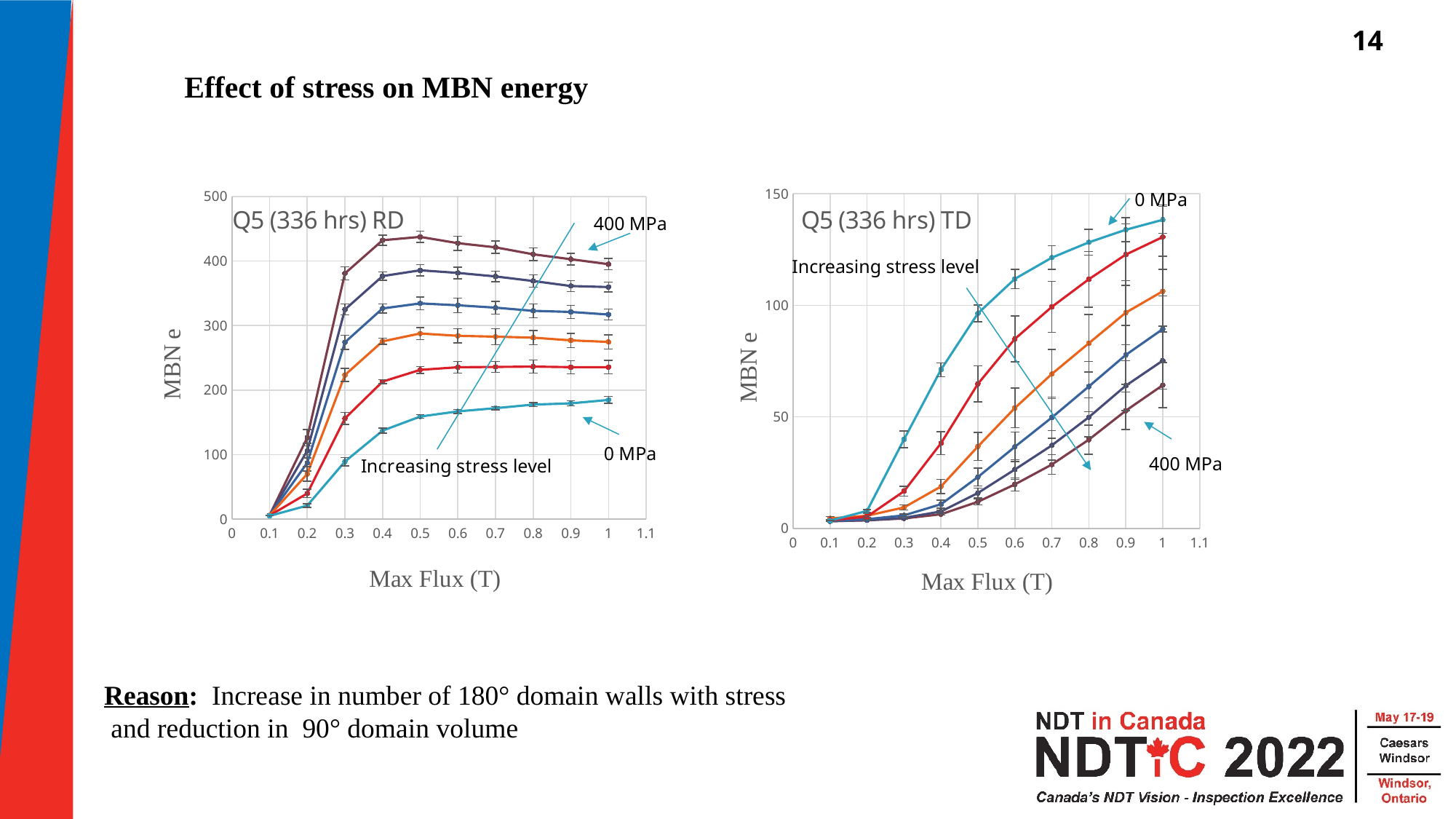
What is the x-axis title of the Q5 (336 hrs) TD chart? Max Flux (T) What is the y-axis title of the Q5 (336 hrs) RD chart? MBN e What kind of chart is the Q5 (336 hrs) TD chart on the right? line chart How many lines are plotted in the Q5 (336 hrs) RD chart? 6 In the Q5 (336 hrs) TD chart, which line is higher at 1 T, the 0 MPa line or the 400 MPa line? 0 MPa In the Q5 (336 hrs) TD chart, does the 0 MPa line rise or fall as Max Flux increases from 0.1 T to 1 T? rise In the Q5 (336 hrs) TD chart, is the value of the 0 MPa line at 1 T greater or less than 100? greater In the Q5 (336 hrs) RD chart, is the value of the 0 MPa line at 1 T greater or less than 200? less What kind of chart is the Q5 (336 hrs) RD chart on the left? line chart In the Q5 (336 hrs) RD chart, which line is higher at 1 T, the 400 MPa line or the 0 MPa line? 400 MPa In the Q5 (336 hrs) RD chart, is the value of the 400 MPa line at 0.5 T greater or less than 400? greater